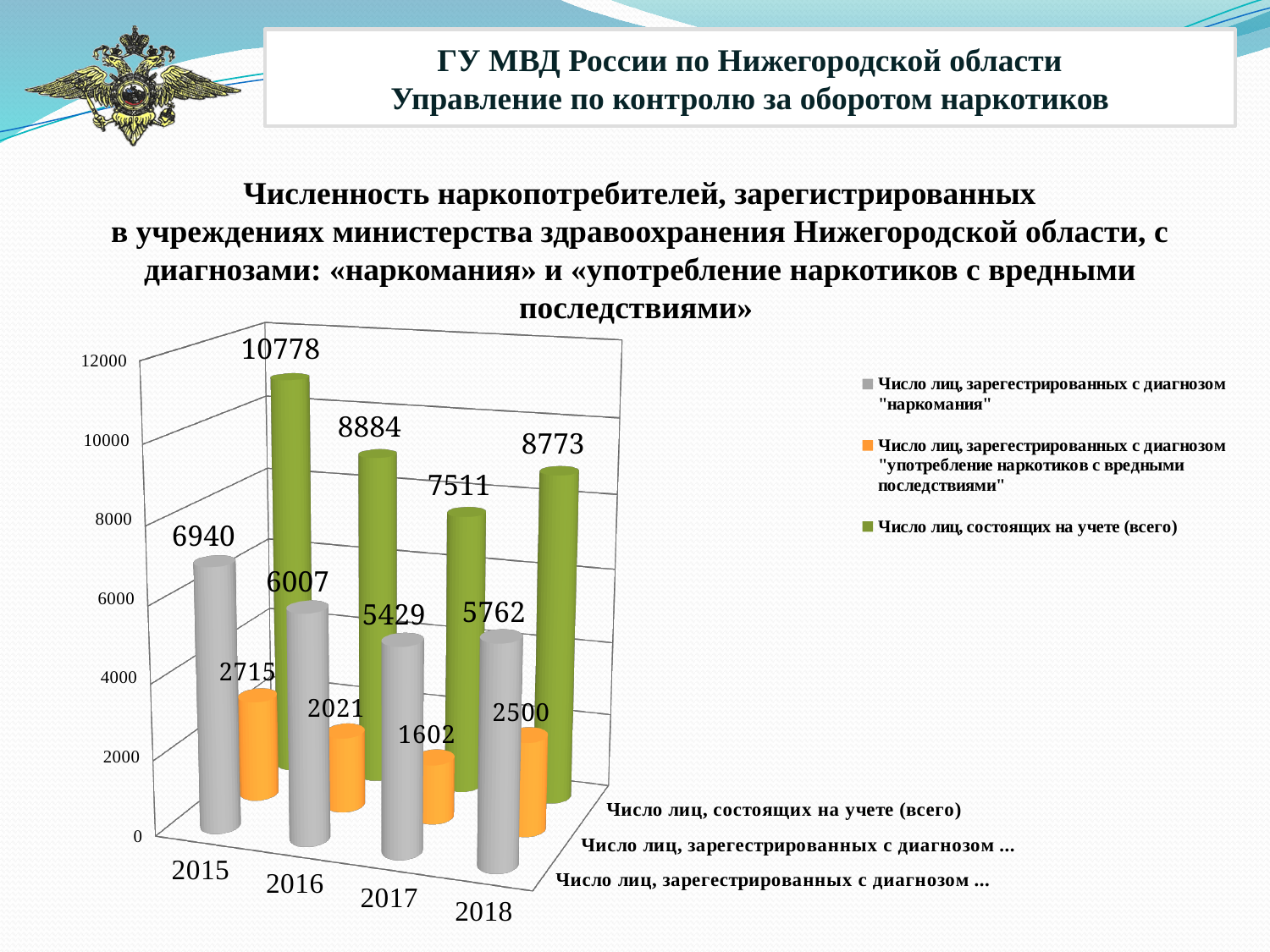
What is the value for "Число лиц, зарегестрированных с диагнозом "употребление наркотиков с вредными последствиями"" in 2018? 2500 In which year is "Число лиц, состоящих на учете (всего)" the lowest? 2017 How many series does the legend list? 3 What is the value for "Число лиц, состоящих на учете (всего)" in 2015? 10778 What kind of chart is shown on the slide? bar chart Does "Число лиц, состоящих на учете (всего)" rise or fall from 2015 to 2017? fall What colour are the bars for "Число лиц, состоящих на учете (всего)"? green Which is larger: the "употребление наркотиков с вредными последствиями" value for 2016 or for 2018? 2018 What is the value for "Число лиц, зарегестрированных с диагнозом "наркомания"" in 2017? 5429 In which year is "Число лиц, зарегестрированных с диагнозом "наркомания"" the highest? 2015 What is the difference between the "Число лиц, состоящих на учете (всего)" values for 2015 and 2016? 1894 How many years are shown on the x axis? 4